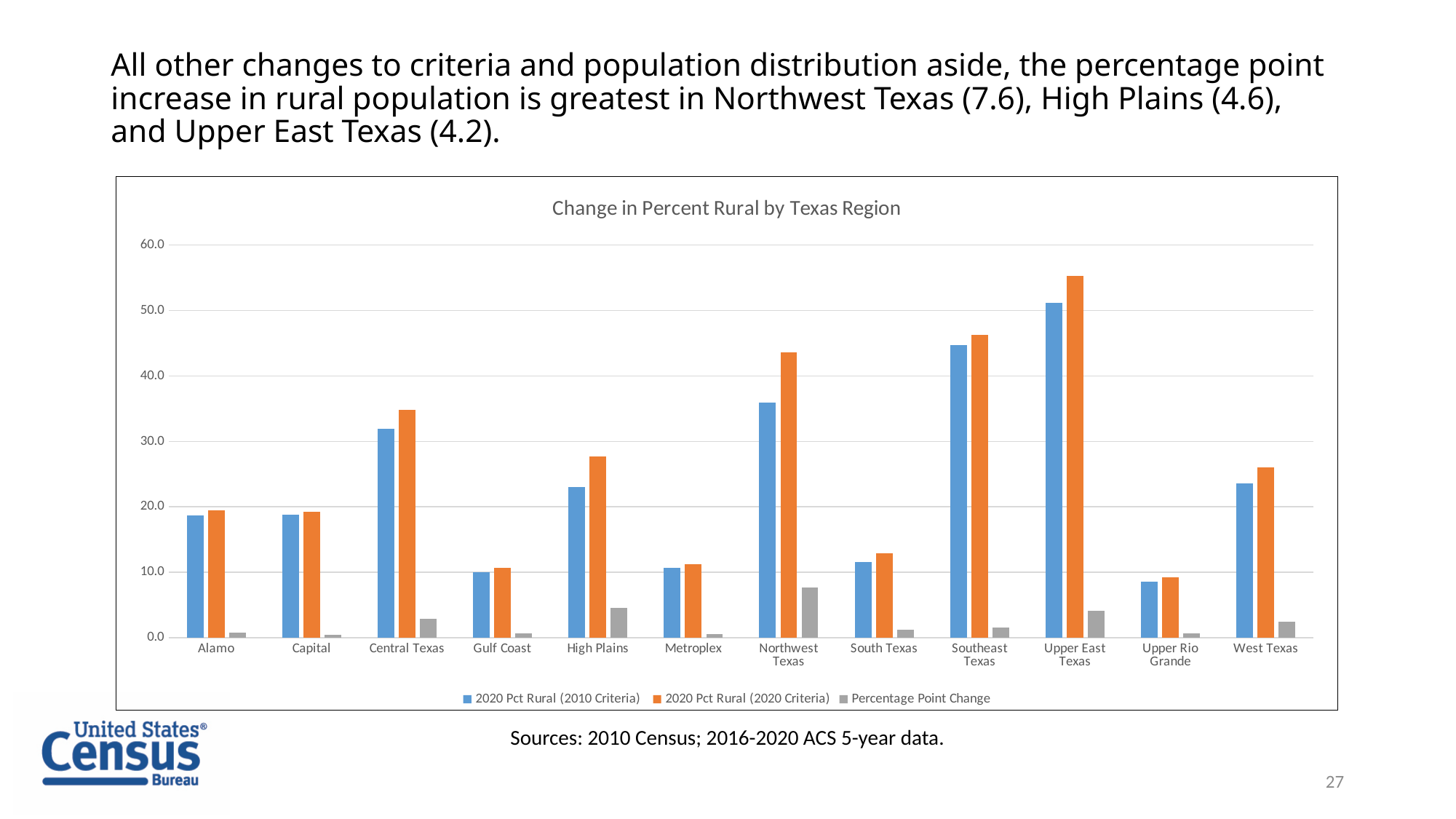
How many series does the chart legend list? 3 Which region has the lowest value for 2020 Pct Rural (2010 Criteria)? Upper Rio Grande Which region has the largest Percentage Point Change? Northwest Texas Which is larger: the 2020 Pct Rural (2020 Criteria) value for Central Texas or for High Plains? Central Texas What is the title of the chart? Change in Percent Rural by Texas Region What is the Percentage Point Change for High Plains, as stated on the slide? 4.6 Which region has the highest value for 2020 Pct Rural (2020 Criteria)? Upper East Texas What type of chart is shown on the slide? Bar chart What is the Percentage Point Change for Northwest Texas, as stated on the slide? 7.6 Is the value for Gulf Coast under 2020 Pct Rural (2010 Criteria) greater or less than 20.0? less How many Texas regions are shown on the x axis of the chart? 12 Is the value for Upper East Texas under 2020 Pct Rural (2020 Criteria) greater or less than 50.0? greater